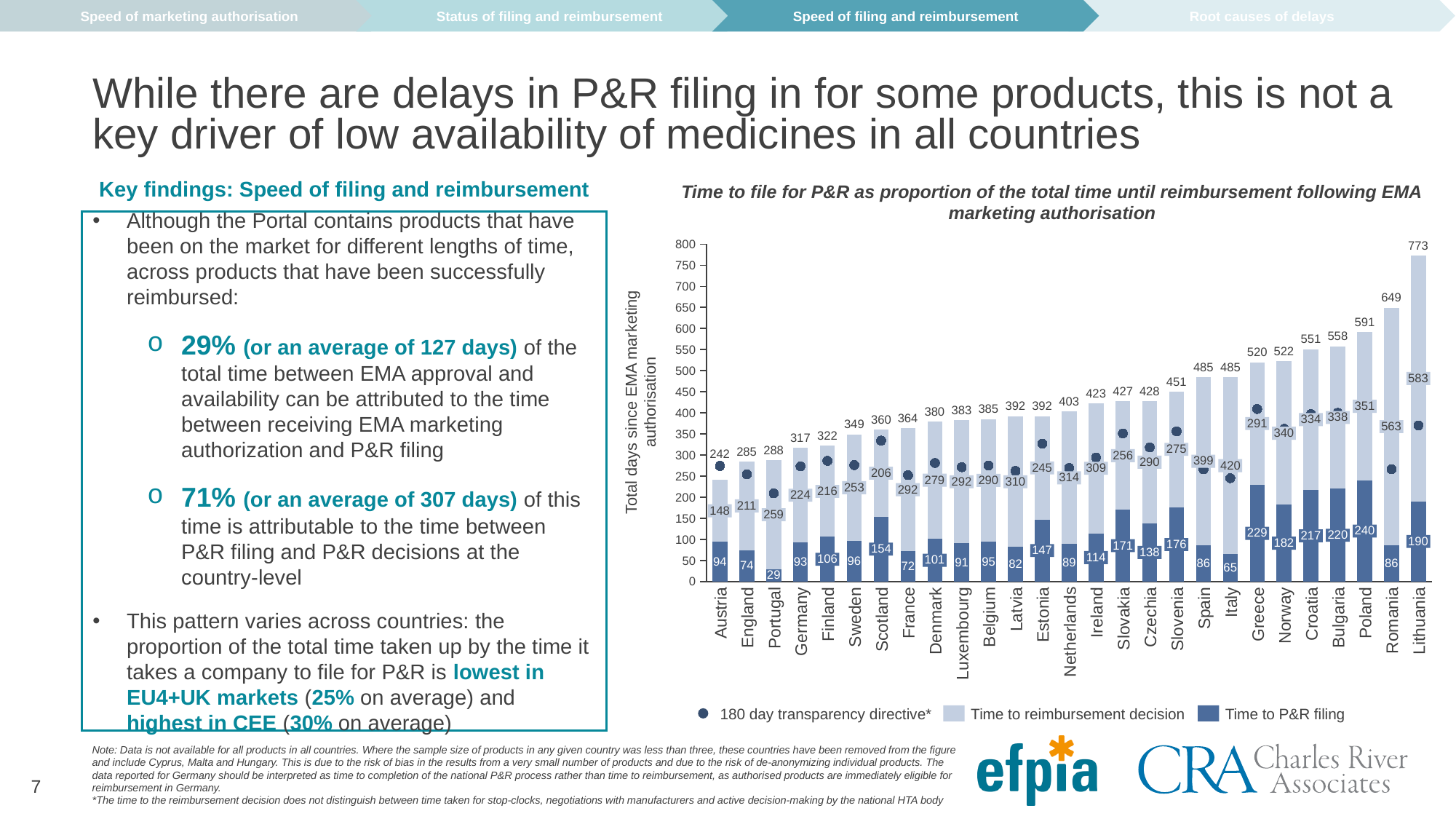
How many series does the legend list? 3 Which country has the lowest total days since EMA marketing authorisation? Austria Which country has the lowest time to P&R filing? Portugal What kind of chart is shown on the slide? Stacked bar chart What is the difference between the total days for Lithuania and Romania? 124 Which country has the highest total days since EMA marketing authorisation? Lithuania How many countries are shown on the x axis? 27 What is the time to P&R filing for Greece? 229 What is the time to reimbursement decision for Romania? 563 Which has a higher total number of days, Poland or Bulgaria? Poland Do the total days per country rise or fall from left to right along the x axis? Rise What is the total number of days for Lithuania? 773